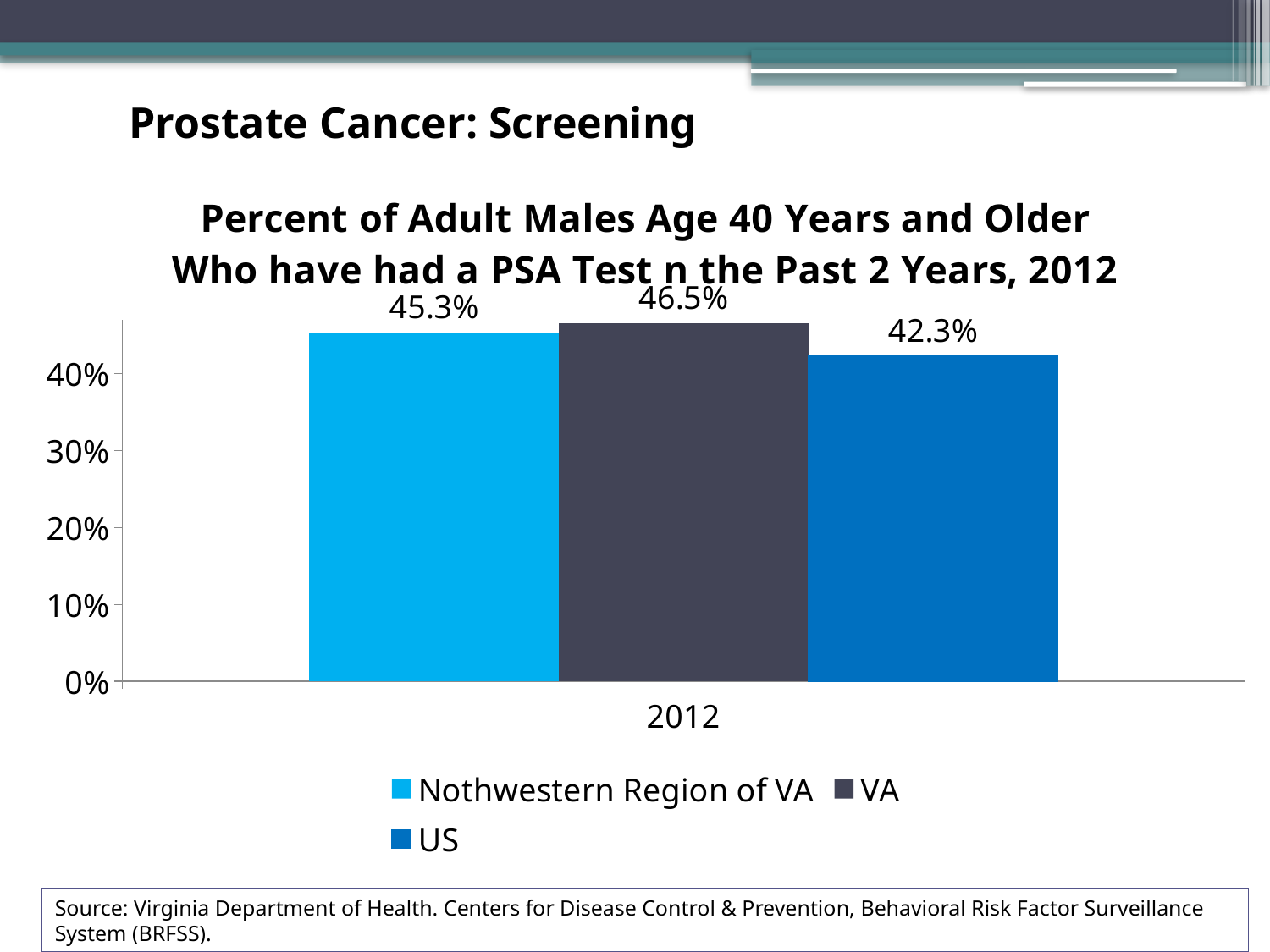
Which year is shown on the x axis of the chart? 2012 What is the value for US in 2012? 42.3% What is the difference between the Nothwestern Region of VA value and the US value? 3.0% What is the value for Nothwestern Region of VA in 2012? 45.3% How many series does the legend list? 3 What is the value for VA in 2012? 46.5% Which series has the highest value? VA Is the value for US greater or less than 40%? greater Which series has the lowest value? US What is the difference between the VA value and the US value? 4.2% Which is larger, the value for Nothwestern Region of VA or the value for US? Nothwestern Region of VA What kind of chart is shown on the slide? bar chart